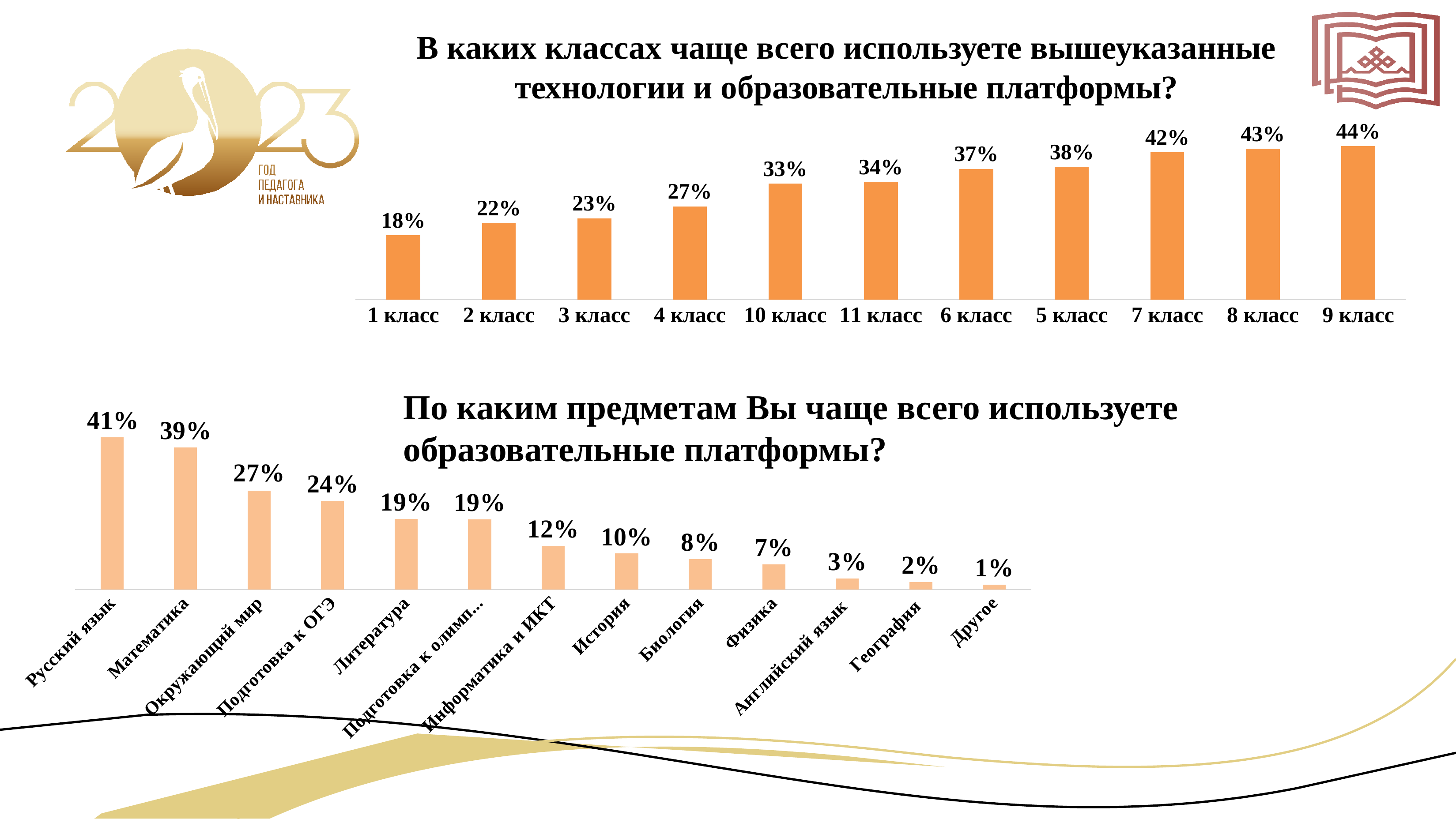
In the top chart (В каких классах чаще всего используете вышеуказанные технологии и образовательные платформы?), what is the value for 1 класс? 18% In the top chart, how many classes are shown? 11 In the top chart, do the values rise or fall from left to right? rise In the top chart, what is the value for 10 класс? 33% In the top chart, which class has the highest value? 9 класс In the bottom chart, which subject has the highest value? Русский язык In the bottom chart (По каким предметам Вы чаще всего используете образовательные платформы?), what is the value for Математика? 39% In the bottom chart, which is larger: the value for История or the value for Физика? История In the top chart, what is the difference between the values for 9 класс and 1 класс? 26% What type of chart is the bottom chart? bar chart In the bottom chart, which category has the lowest value? Другое In the top chart, which class has the lowest value? 1 класс